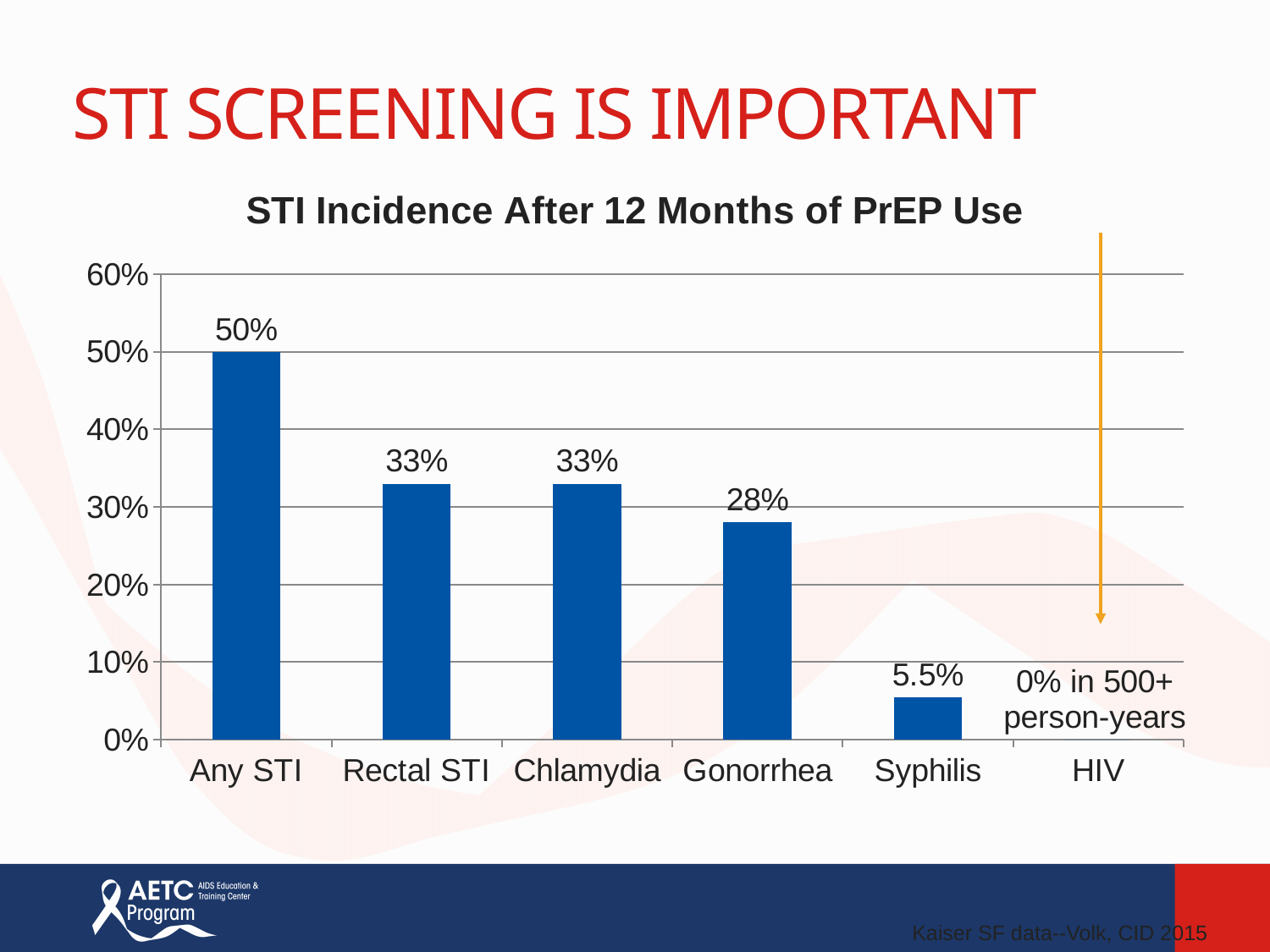
What is the value shown for Rectal STI? 33% What is the value shown for Syphilis? 5.5% Is the value for Chlamydia greater or less than 30%? greater What is the title of the chart? STI Incidence After 12 Months of PrEP Use Which is larger, the value for Gonorrhea or the value for Syphilis? Gonorrhea How many categories are shown on the x axis? 6 Which category has the lowest value? HIV What is the value shown for Gonorrhea? 28% What kind of chart is shown on the slide? bar chart What is the STI incidence value shown for Any STI? 50% Which category has the highest value? Any STI What is the difference between the values for Any STI and Gonorrhea? 22%